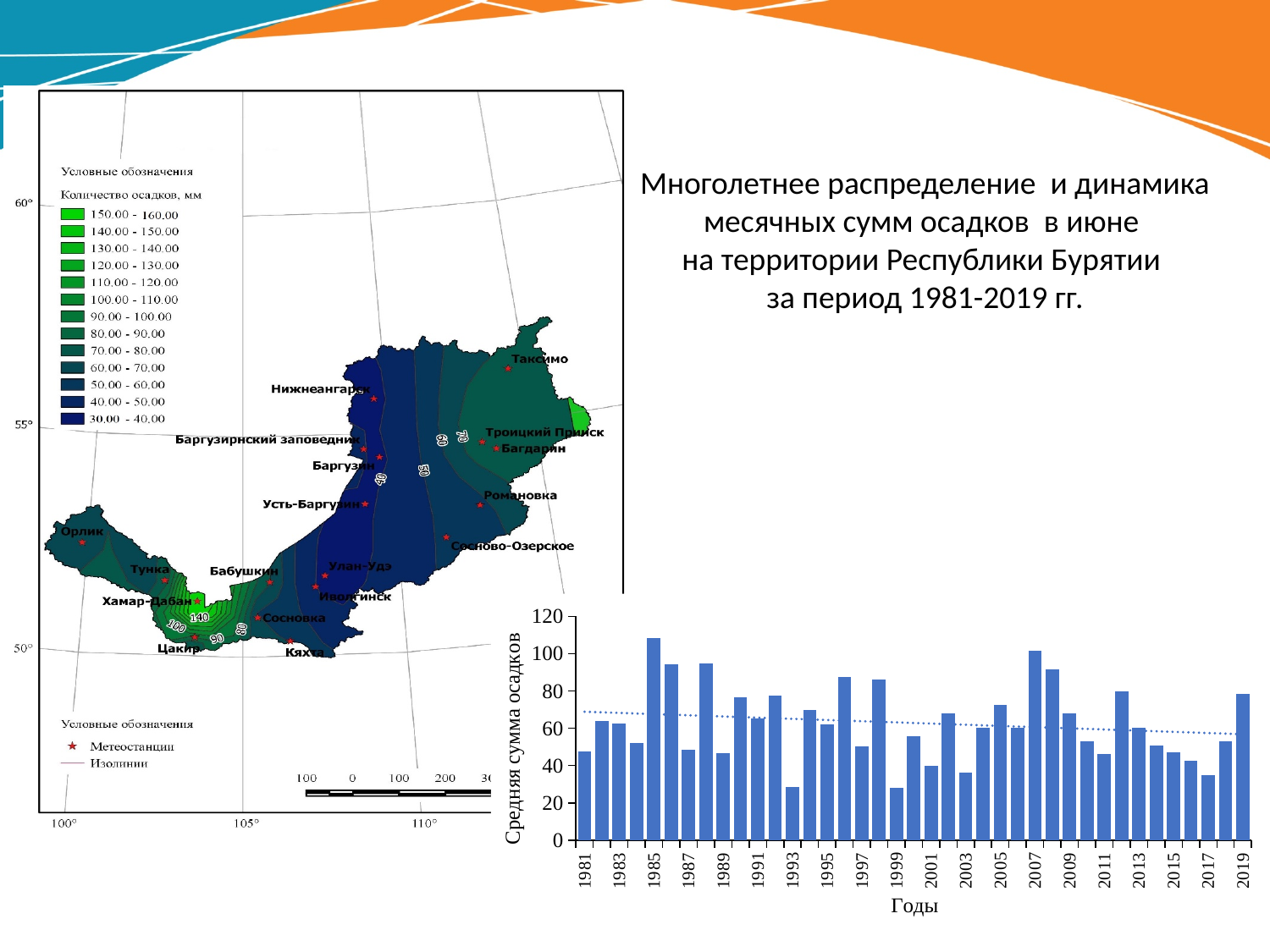
In the bar chart, is the value for 1985 greater or less than 100? greater In the bar chart, is the value for 2019 greater or less than 60? greater What kind of chart is shown at the bottom right of the slide? bar chart According to the dotted trend line in the bar chart, do the values rise or fall over the years 1981 to 2019? fall In the bar chart, is the value for 2017 greater or less than 40? less How many years (bars) are plotted in the bar chart? 39 What is the label of the vertical axis of the bar chart? Средняя сумма осадков In the bar chart, which year has the highest average precipitation sum? 1985 In the bar chart, which year has the larger value, 1993 or 1994? 1994 In the bar chart, which year has the larger value, 1986 or 1987? 1986